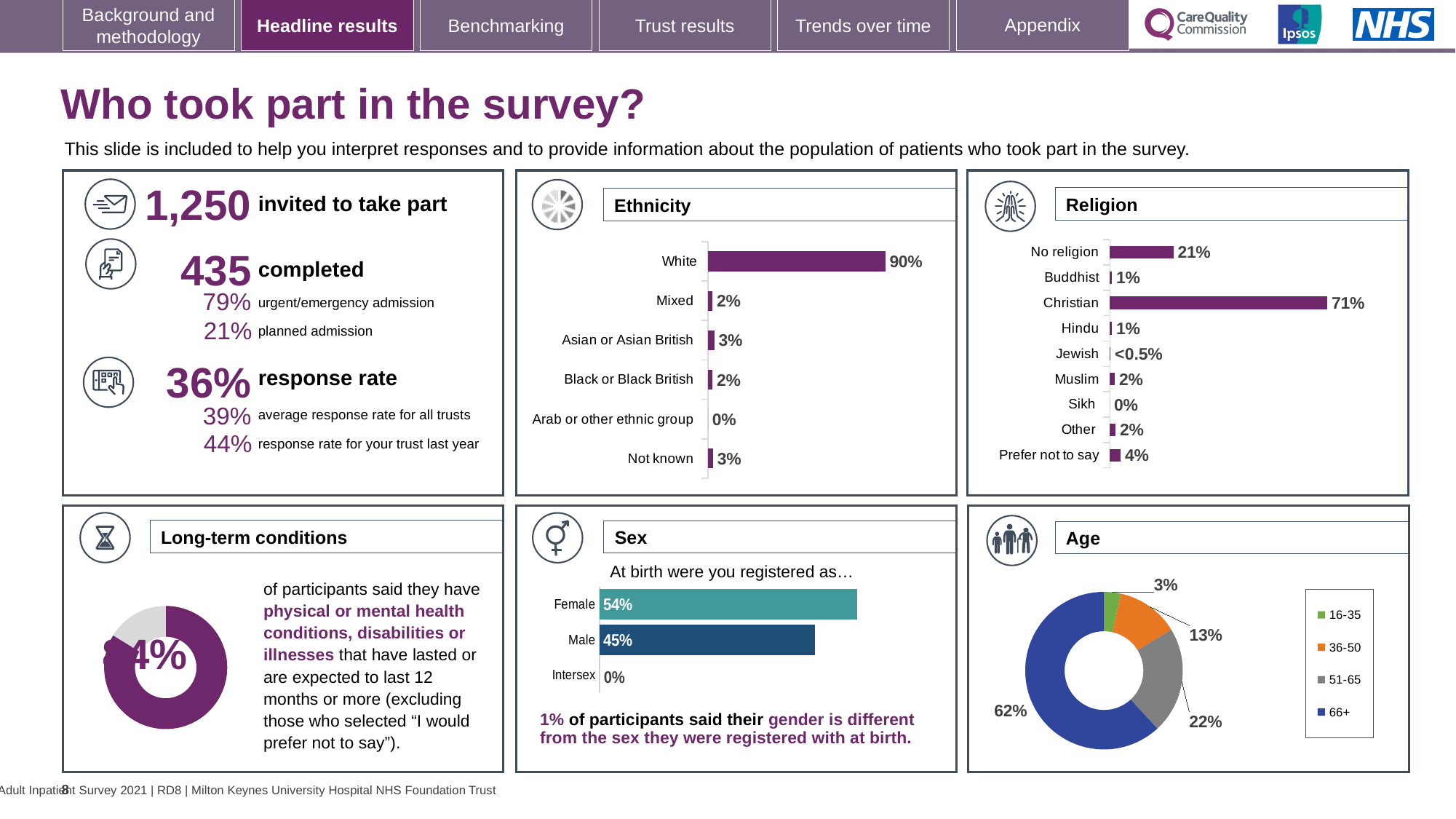
In the Sex chart, which is larger, Female or Male? Female How many categories are shown in the Ethnicity chart? 6 In the Age chart, what share of participants were aged 66+? 62% In the Sex chart, what percentage of participants were registered as Female at birth? 54% In the Ethnicity chart, what is the value for Arab or other ethnic group? 0% In the Ethnicity chart, which category has the highest value? White How many categories are shown in the Religion chart? 9 In the Religion chart, what is the value shown for Jewish? <0.5% In the Religion chart, what percentage of participants were Christian? 71% In the Religion chart, what is the difference between the Christian and No religion values? 50% In the Ethnicity chart, what percentage of participants were White? 90% What type of chart is the Age chart? Donut chart